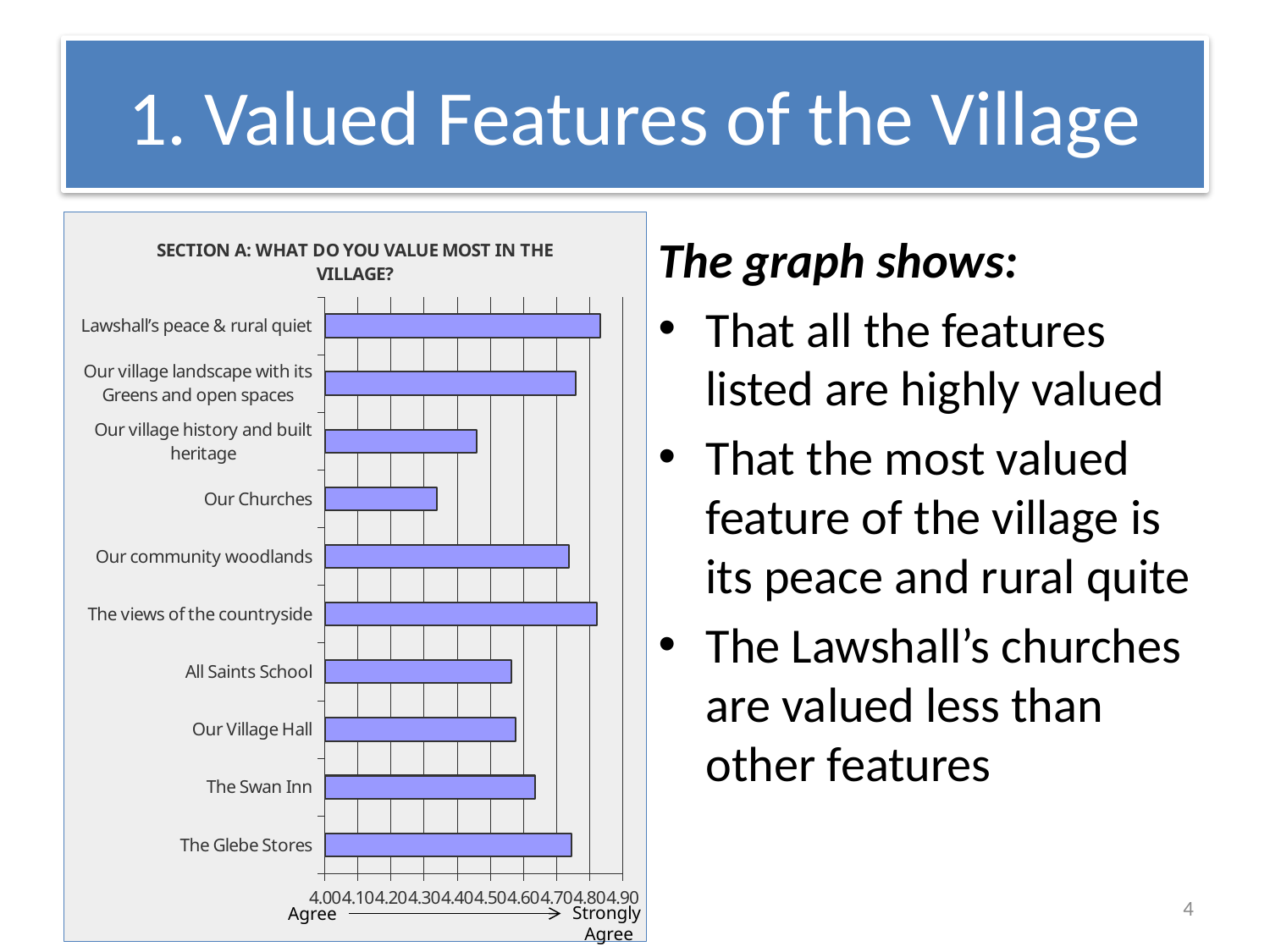
Which has the larger value, Our Churches or Our village history and built heritage? Our village history and built heritage Is the value for The Swan Inn greater or less than 4.70? less What is the title of the chart? SECTION A: WHAT DO YOU VALUE MOST IN THE VILLAGE? Which has the larger value, The Glebe Stores or Our Village Hall? The Glebe Stores Is the value for The Glebe Stores greater or less than 4.70? greater Is the value for Our village history and built heritage greater or less than 4.40? greater How many features (categories) are plotted in the chart? 10 What do the two ends of the horizontal axis represent, according to the labels below it? Agree to Strongly Agree Which feature has the lowest value in the chart? Our Churches What kind of chart is shown on the slide? Bar chart